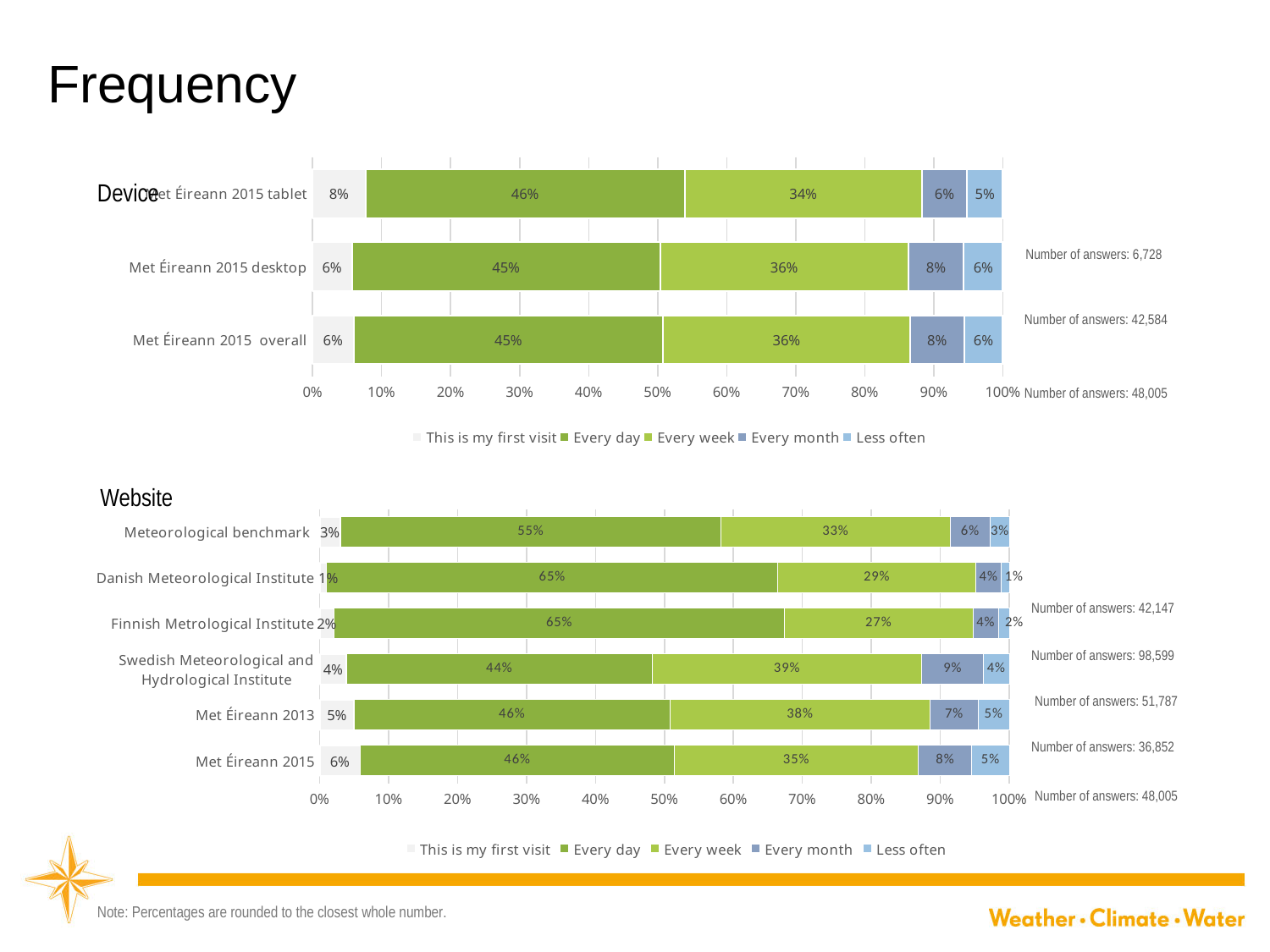
In the Device chart, what is the 'Every week' value for Met Éireann 2015 desktop? 36% In the Device chart, what percentage of Met Éireann 2015 tablet respondents visit every day? 46% In the Website chart, what is the 'Every day' value for the Meteorological benchmark? 55% In the Website chart, which category has the lowest 'Every week' value? Finnish Metrological Institute In the Website chart, what is the difference between the 'Every day' values for Danish Meteorological Institute and Met Éireann 2015? 19% In the Device chart, what is the 'This is my first visit' value for Met Éireann 2015 tablet? 8% In the Website chart, how many categories are plotted? 6 What type of chart is the Website chart? Stacked bar chart In the Website chart, is the 'Every month' value larger for Swedish Meteorological and Hydrological Institute or for Danish Meteorological Institute? Swedish Meteorological and Hydrological Institute In the Device chart, how many series does the legend list? 5 In the Website chart, which category has the highest 'Every week' value? Swedish Meteorological and Hydrological Institute In the Device chart, how many categories are plotted? 3